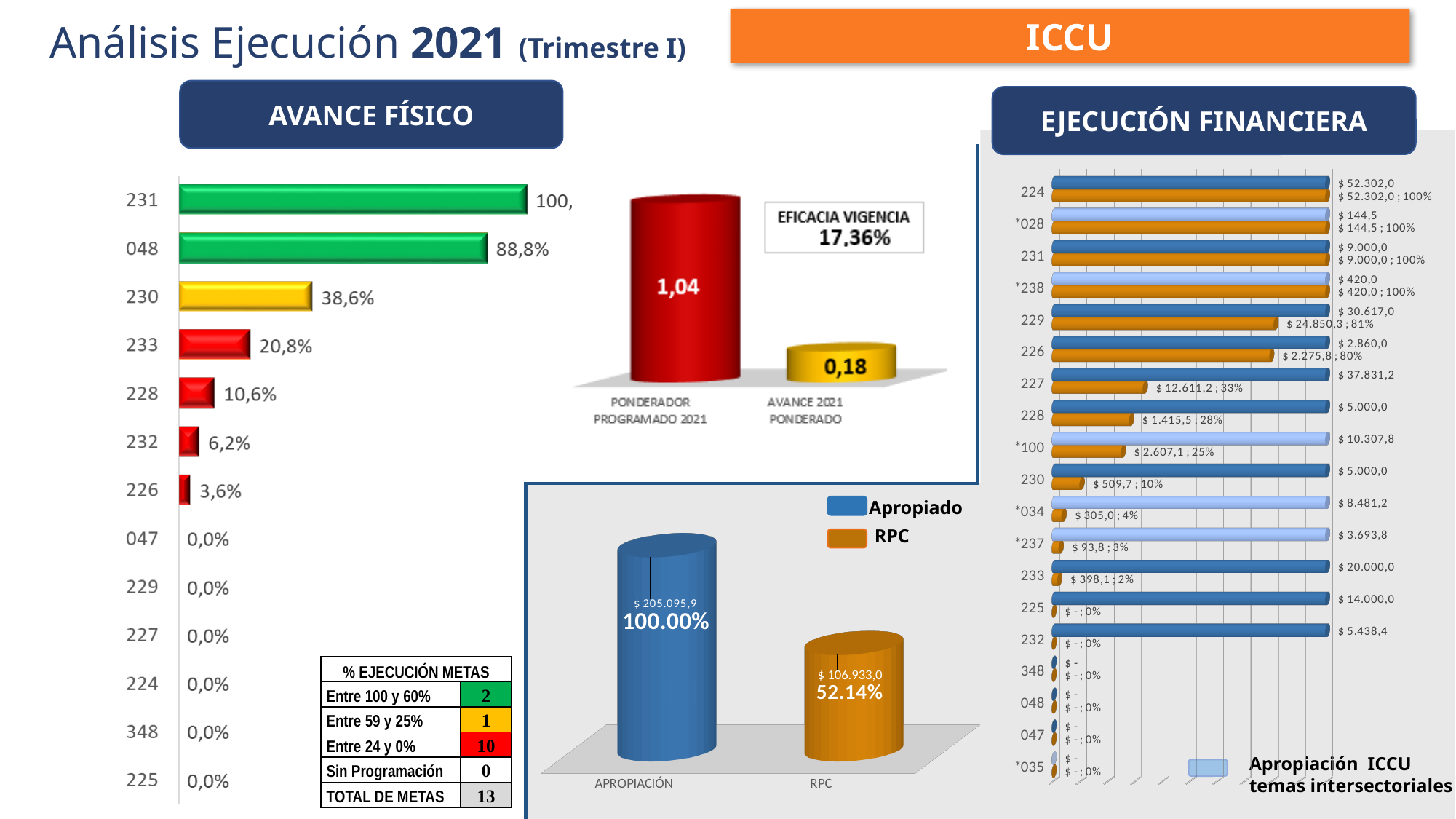
In the PONDERADOR PROGRAMADO 2021 / AVANCE 2021 PONDERADO chart, what is the value for PONDERADOR PROGRAMADO 2021? 1,04 In the APROPIACIÓN / RPC chart at the bottom centre, what percentage is shown for RPC? 52.14% In the AVANCE FÍSICO chart, how many categories are plotted? 13 In the AVANCE FÍSICO chart, what is the value for category 048? 88,8% In the AVANCE FÍSICO chart, which is larger, the value for 232 or the value for 226? 232 In the AVANCE FÍSICO chart, what is the value for category 233? 20,8% How many series does the legend of the EJECUCIÓN FINANCIERA chart list? 2 In the AVANCE FÍSICO chart, what is the difference between the values for 230 and 228? 28,0% In the EJECUCIÓN FINANCIERA chart, what is the RPC value for category 229? $ 24.850,3 In the PONDERADOR PROGRAMADO 2021 / AVANCE 2021 PONDERADO chart, what is the value for AVANCE 2021 PONDERADO? 0,18 In the AVANCE FÍSICO chart, which category has the highest value? 231 In the EJECUCIÓN FINANCIERA chart, what is the Apropiado value for category 227? $ 37.831,2